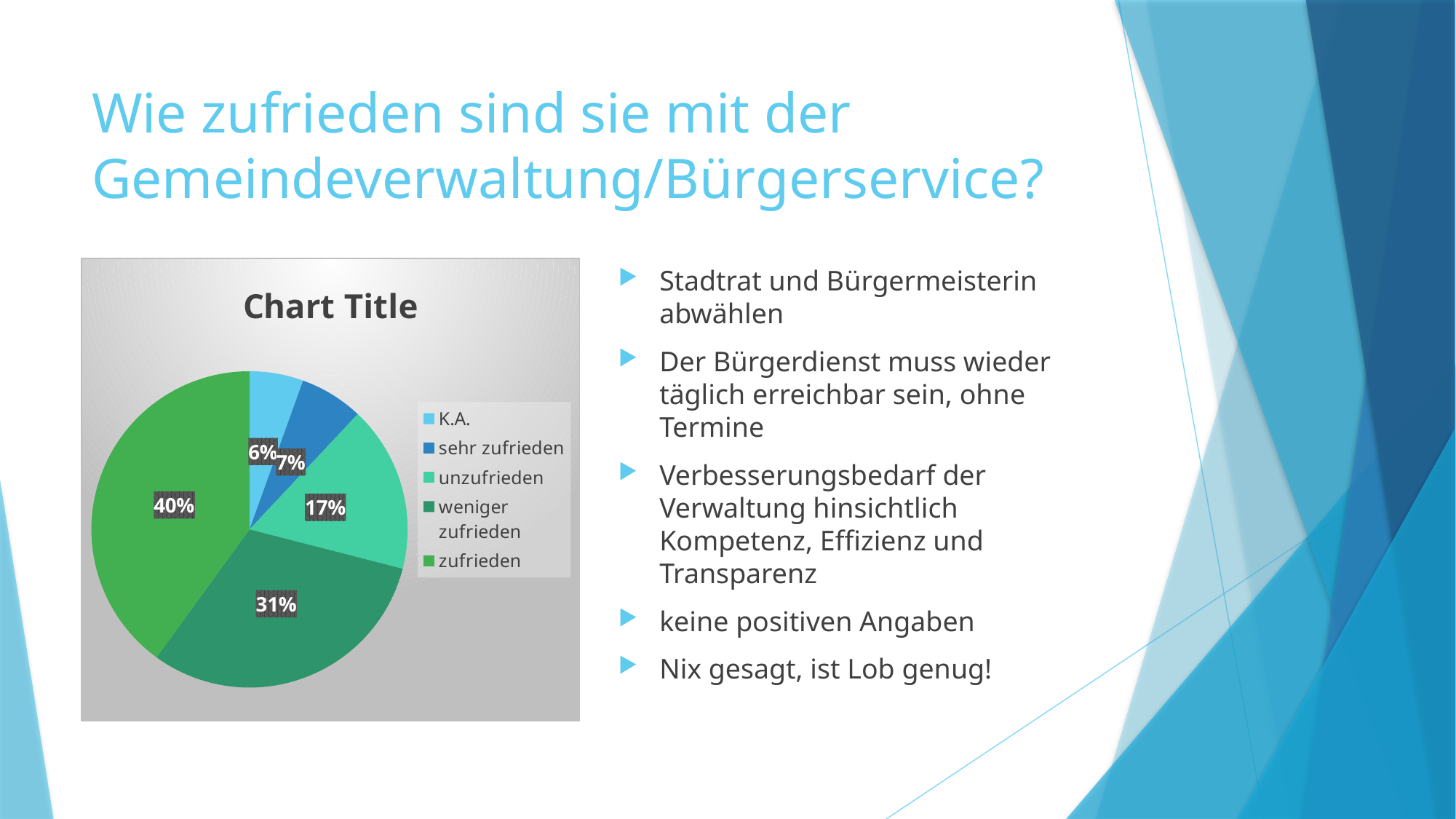
How many categories does the pie chart have? 5 What type of chart is shown on the slide? pie chart Which category has the smallest slice of the pie? K.A. What share of the pie does "weniger zufrieden" have? 31% Which category has the largest slice of the pie? zufrieden What share of the pie does "zufrieden" have? 40% What share of the pie does "K.A." have? 6% Which is larger, the slice for "unzufrieden" or the slice for "sehr zufrieden"? unzufrieden What is the title of the chart? Chart Title What is the difference in percentage points between "zufrieden" and "weniger zufrieden"? 9